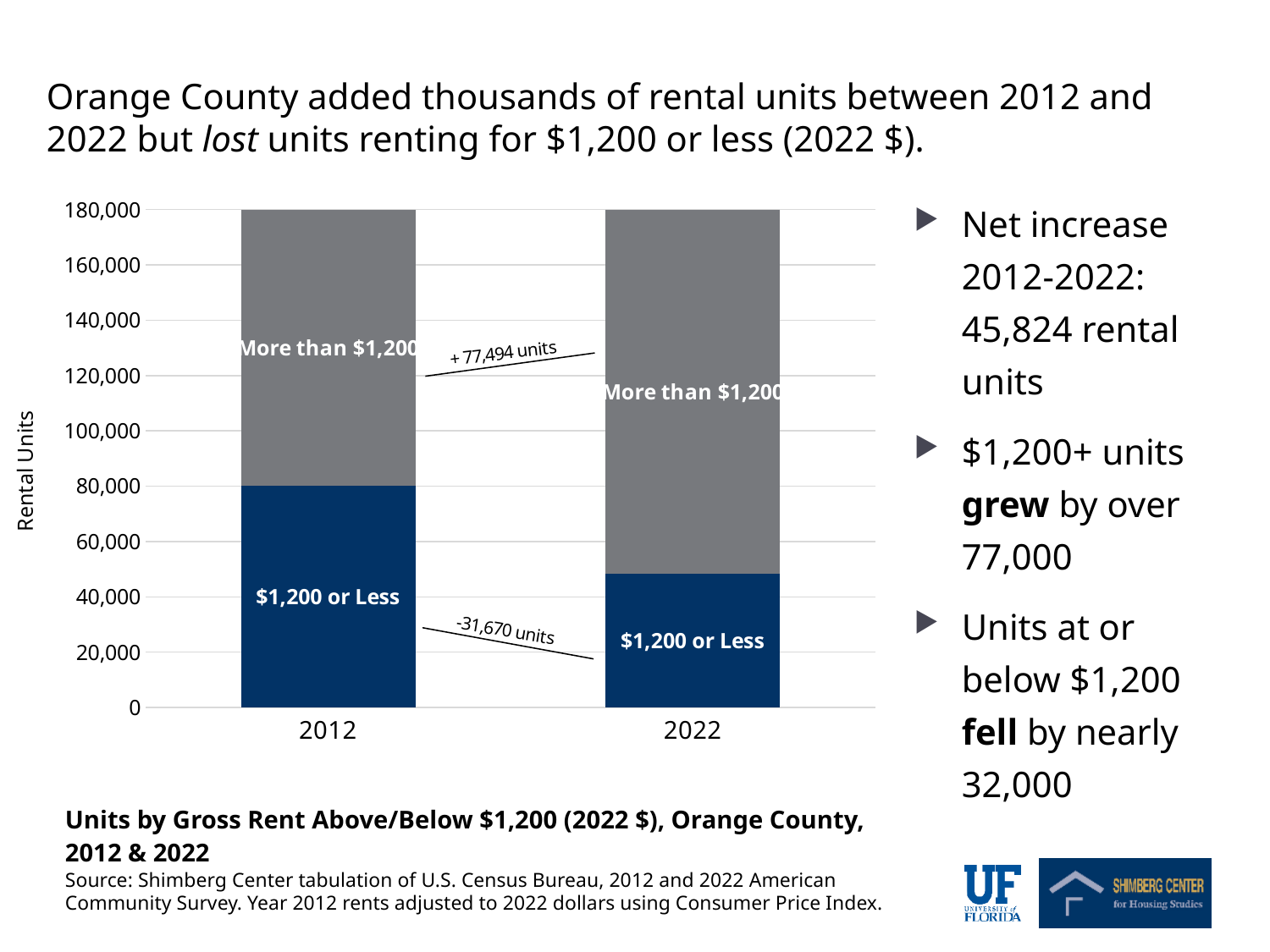
Is the value of the '$1,200 or Less' segment for 2022 greater or less than 60,000? less According to the annotation on the chart, by how many units did the 'More than $1,200' segment change between 2012 and 2022? + 77,494 units According to the annotation on the chart, by how many units did the '$1,200 or Less' segment change between 2012 and 2022? -31,670 units Into how many rent segments is each bar divided? 2 Is the value of the '$1,200 or Less' segment for 2022 greater or less than 40,000? greater Which year has the larger '$1,200 or Less' segment, 2012 or 2022? 2012 What is the label on the vertical axis of the chart? Rental Units How many years (categories) are shown on the x axis of the chart? 2 What kind of chart is shown on the slide? Stacked bar chart Does the '$1,200 or Less' segment rise or fall from 2012 to 2022? Fall Is the value of the '$1,200 or Less' segment for 2012 greater or less than 60,000? greater What is the title of the chart? Units by Gross Rent Above/Below $1,200 (2022 $), Orange County, 2012 & 2022